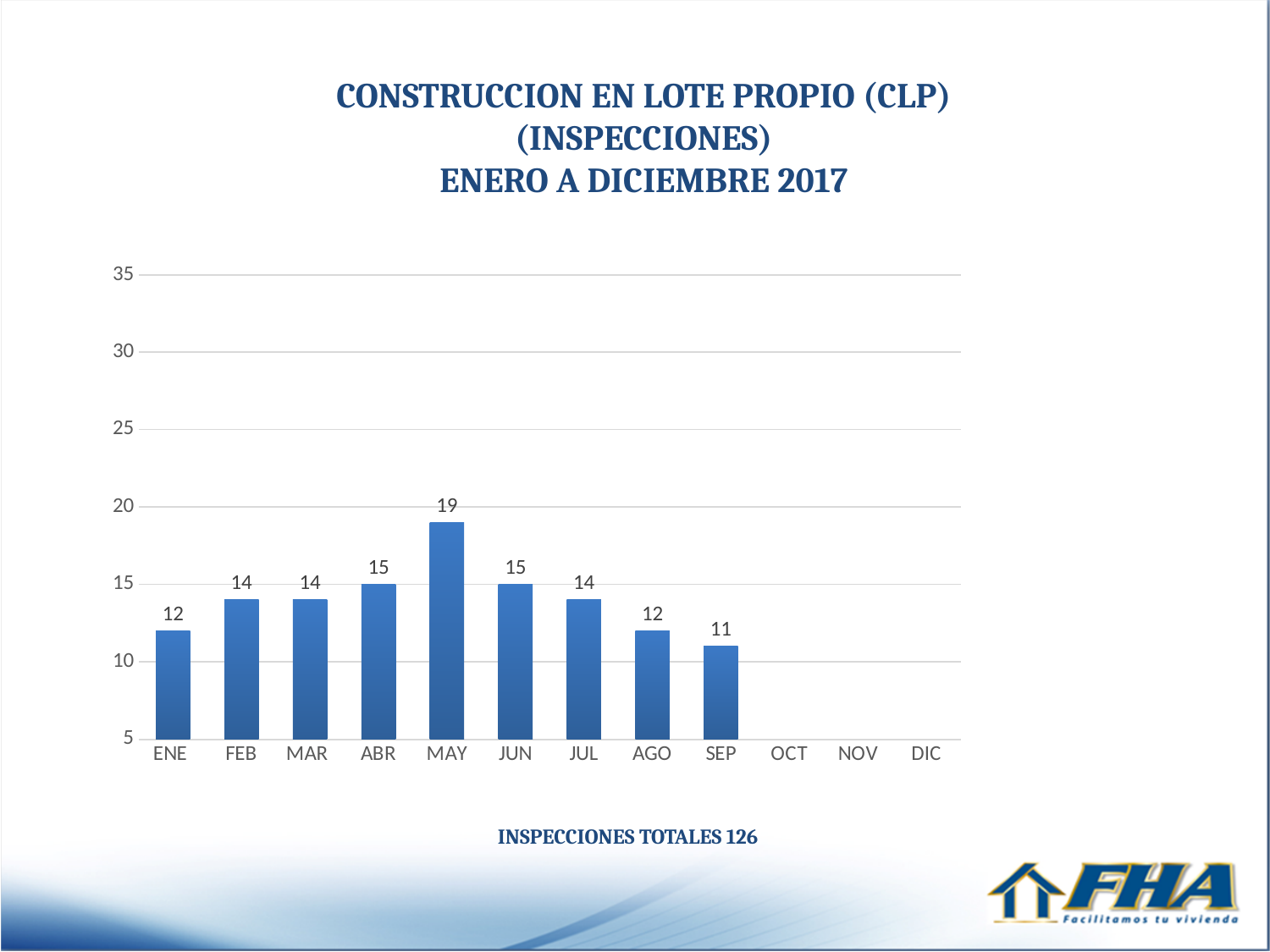
What is the value for SEP? 11 What is the difference between the values for MAY and SEP? 8 Among the months with a bar plotted, which has the lowest value? SEP How many month categories are shown on the x axis? 12 What is the value for MAY? 19 How many months have a bar plotted on the chart? 9 Do the values rise or fall from MAY to SEP? fall Which is larger, the value for ABR or the value for AGO? ABR What is the value for ENE? 12 Which month has the highest value? MAY Is the value for MAY greater or less than 15? greater What kind of chart is shown on the slide? bar chart